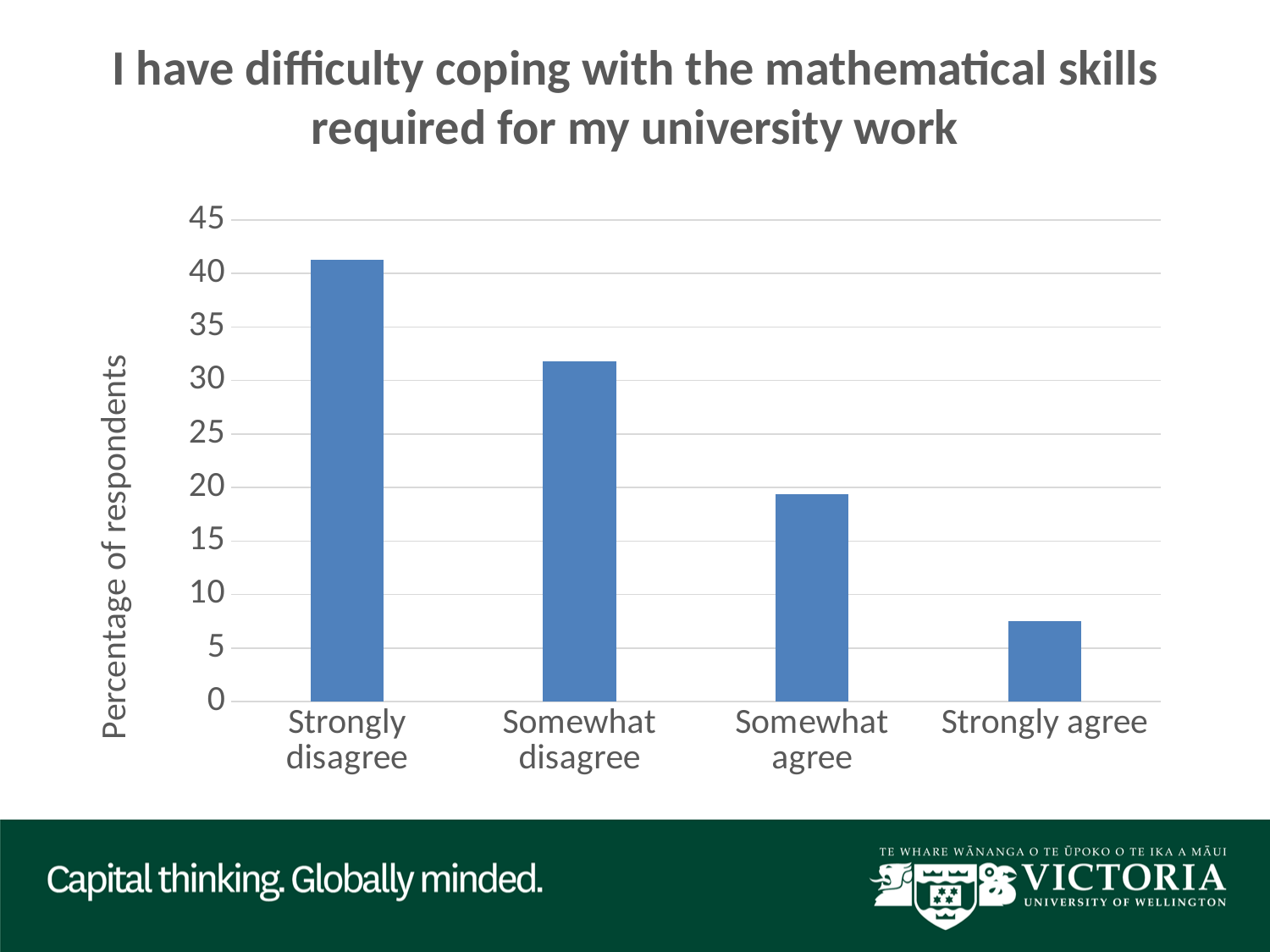
Is the value for Strongly agree greater or less than 10? less Is the value for Somewhat agree greater or less than 20? less What is the title of the chart? I have difficulty coping with the mathematical skills required for my university work What is the label of the vertical axis? Percentage of respondents Which category has the highest percentage of respondents? Strongly disagree What type of chart is shown on the slide? bar chart Which is larger, the value for Somewhat disagree or the value for Somewhat agree? Somewhat disagree Do the values rise or fall moving from left to right along the x axis? fall Is the value for Strongly disagree greater or less than 40? greater Which category has the lowest percentage of respondents? Strongly agree How many categories are shown on the x axis? 4